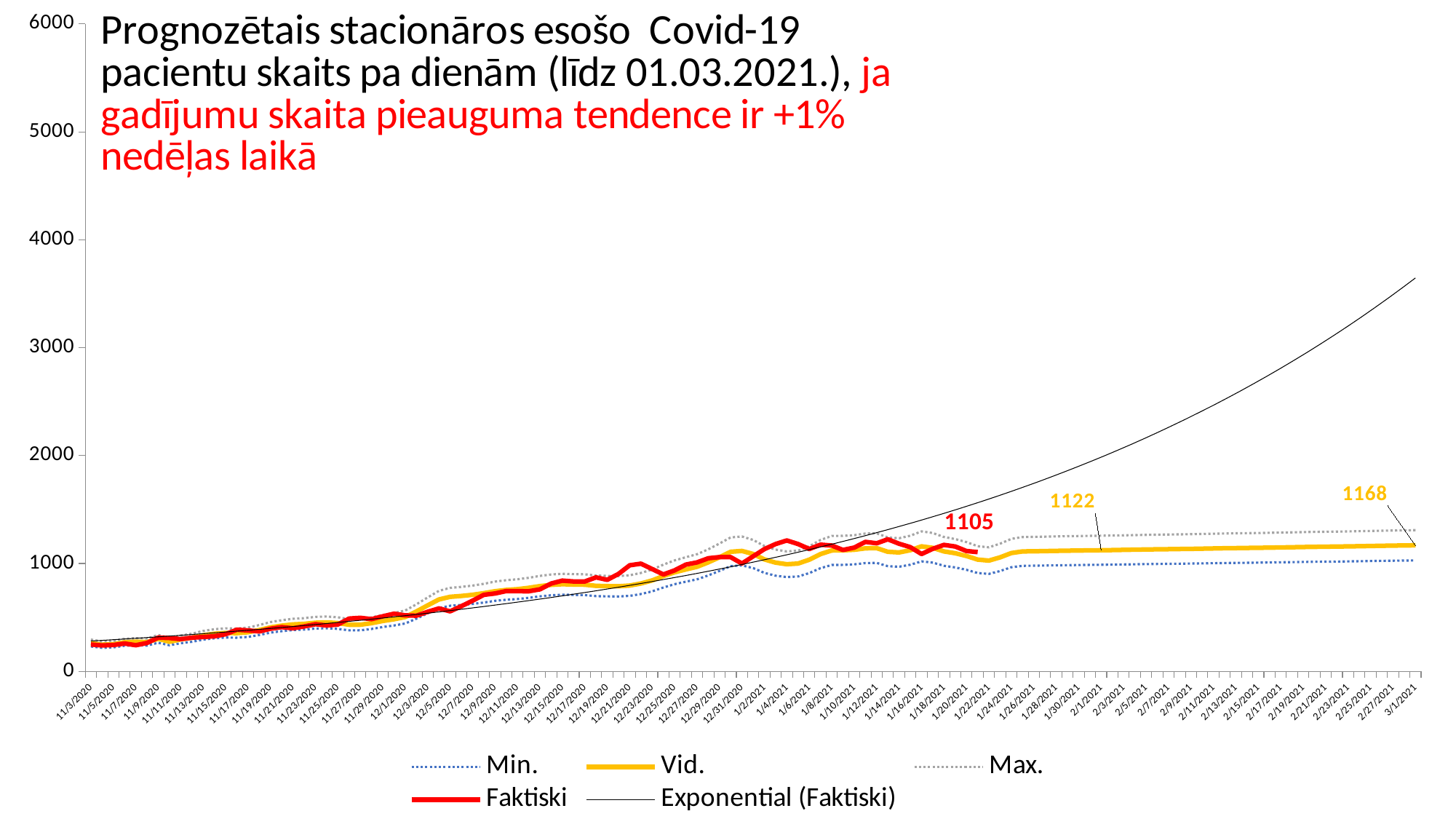
Does the Exponential (Faktiski) line rise or fall along the x axis? rise Which is larger: the Vid. value at 3/1/2021 or the last labelled Faktiski value? Vid. value at 3/1/2021 Is the value of the Max. line at 3/1/2021 greater or less than 2000? less What is the labelled value at the end of the Faktiski line? 1105 Which series has the highest value at 3/1/2021? Exponential (Faktiski) What colour is the Faktiski line? red What kind of chart is shown on the slide? line chart What is the difference between the Vid. values labelled 1168 and 1122? 46 What is the labelled value of the Vid. line at 2/1/2021? 1122 How many series does the legend list? 5 What is the labelled value of the Vid. line at 3/1/2021? 1168 Is the value of the Exponential (Faktiski) line at 3/1/2021 greater or less than 3000? greater